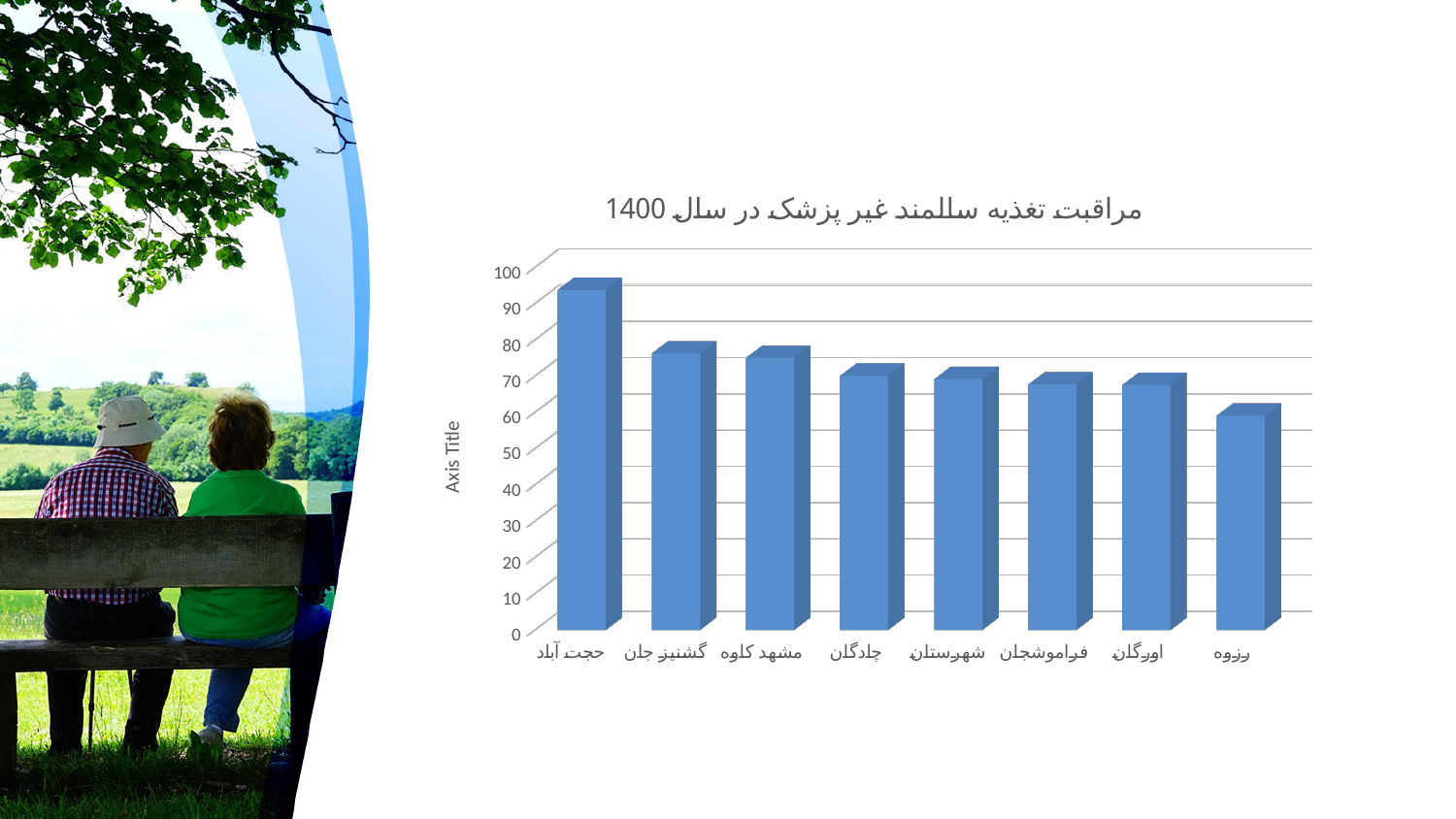
Which category has the lowest value in the chart? رزوه Which category has the highest value in the chart? حجت آباد How many categories are shown on the x axis of the chart? 8 Is the value for چادگان greater or less than 80? less Do the values rise or fall moving from left to right along the x axis? fall Is the value for گشنیز جان greater or less than 70? greater What is the title of the chart? مراقبت تغذیه سالمند غیر پزشک در سال 1400 What kind of chart is shown on the slide? bar chart Is the value for حجت آباد greater or less than 80? greater